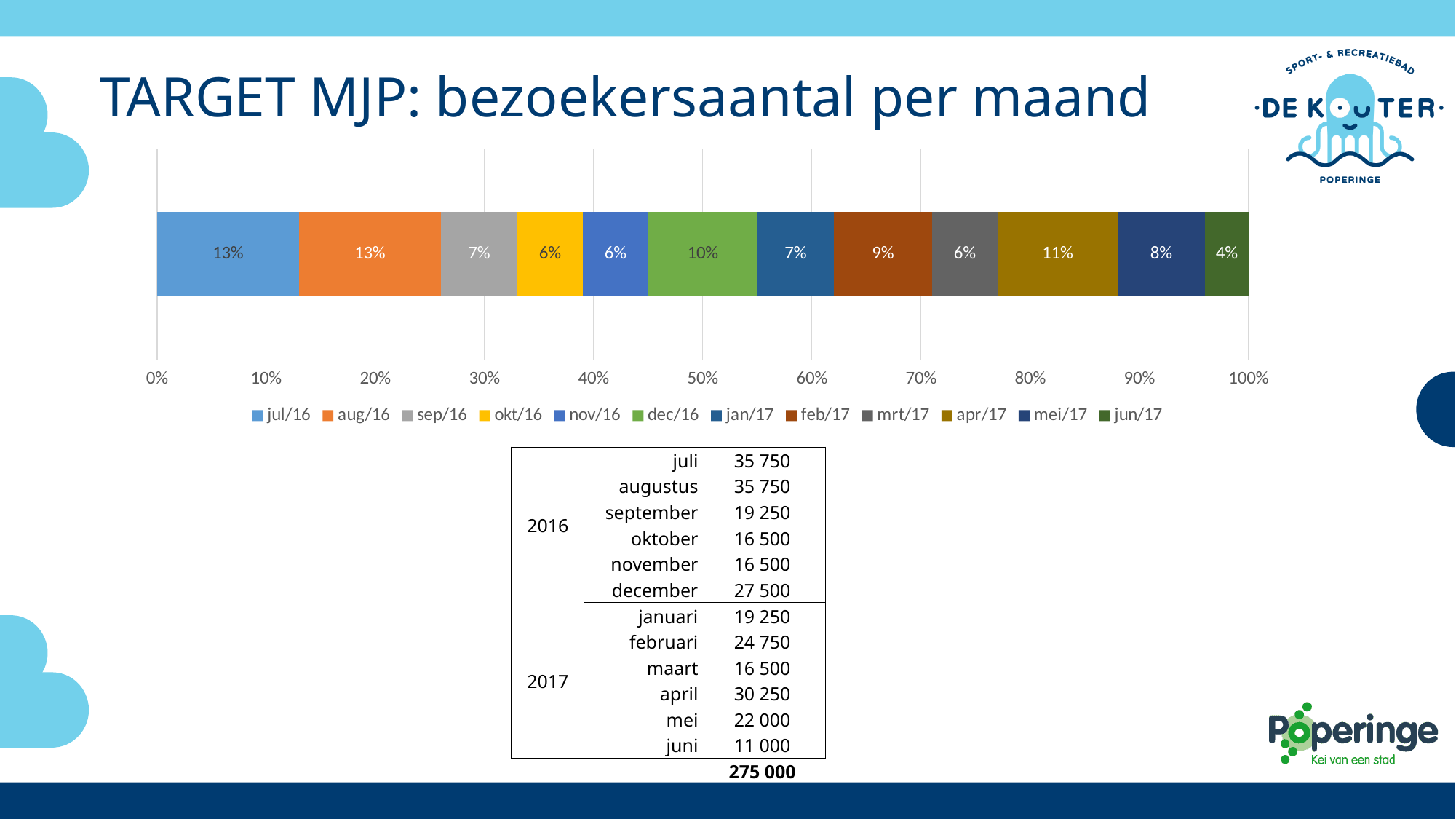
What percentage is labelled on the dec/16 segment of the bar? 10% What is the highest value shown on the chart's horizontal axis? 100% Which legend entry is shown in orange? aug/16 Which segment is larger, dec/16 or feb/17? dec/16 What percentage does the jul/16 segment show in the stacked bar? 13% What kind of chart is shown on the slide? Stacked bar chart What is the difference in percentage points between the apr/17 segment and the jun/17 segment? 7 What percentage is shown for mei/17 in the chart? 8% What percentage is shown for apr/17 in the chart? 11% How many series does the chart legend list? 12 Which month segment has the smallest percentage in the stacked bar? jun/17 Which segment is larger, aug/16 or sep/16? aug/16